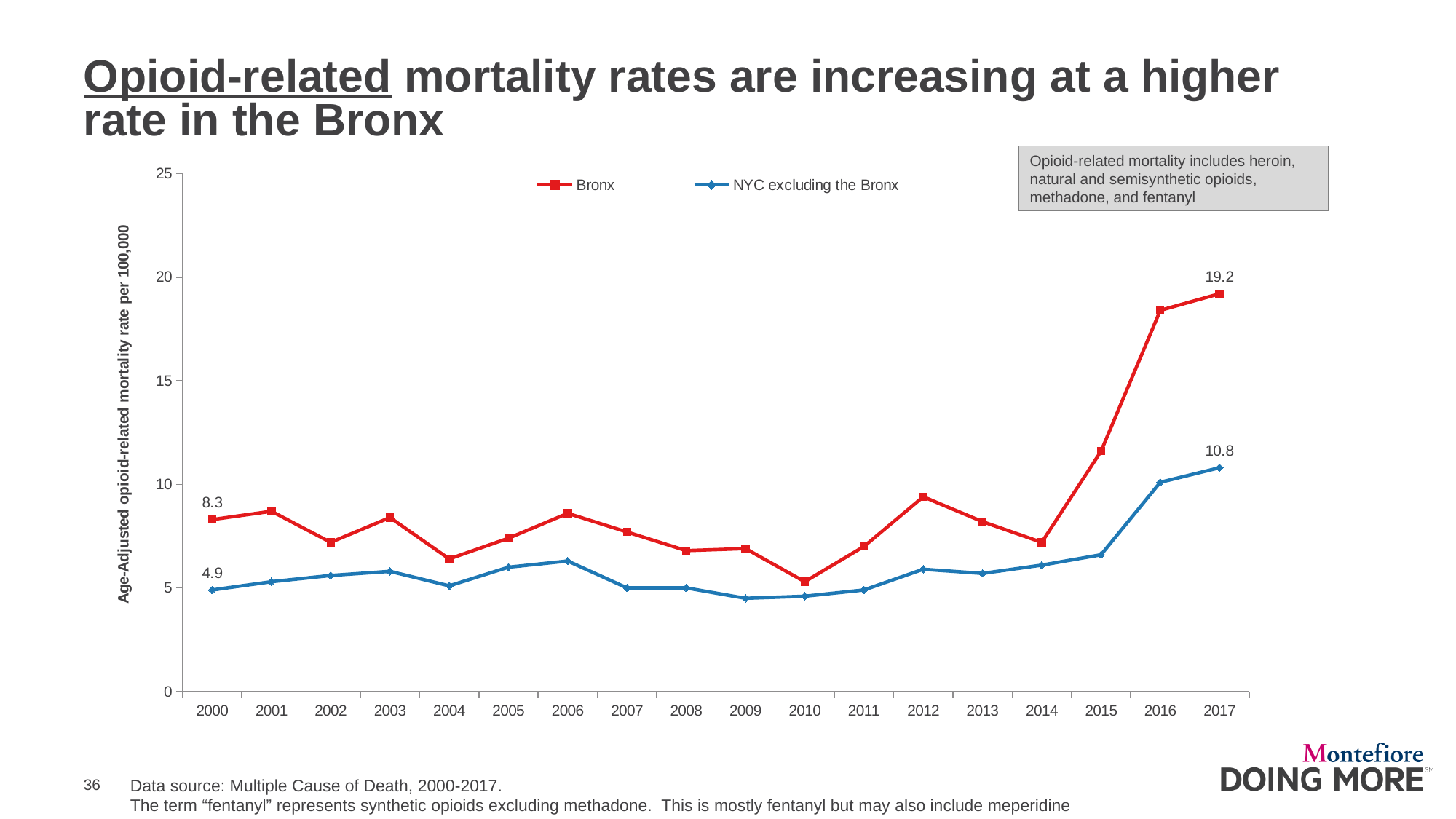
What is the Bronx opioid-related mortality rate in 2017? 19.2 Which series has the higher value in 2017, Bronx or NYC excluding the Bronx? Bronx What is the difference between the Bronx and NYC excluding the Bronx values in 2017? 8.4 By how much did the Bronx rate increase from 2000 to 2017? 10.9 Is the Bronx value for 2010 greater or less than 10? less What type of chart is shown on the slide? line chart What is the Bronx opioid-related mortality rate in 2000? 8.3 How many series does the legend list? 2 What is the value for NYC excluding the Bronx in 2000? 4.9 What is the value for NYC excluding the Bronx in 2017? 10.8 In which year does the Bronx series reach its highest value? 2017 How many years are shown on the x axis? 18